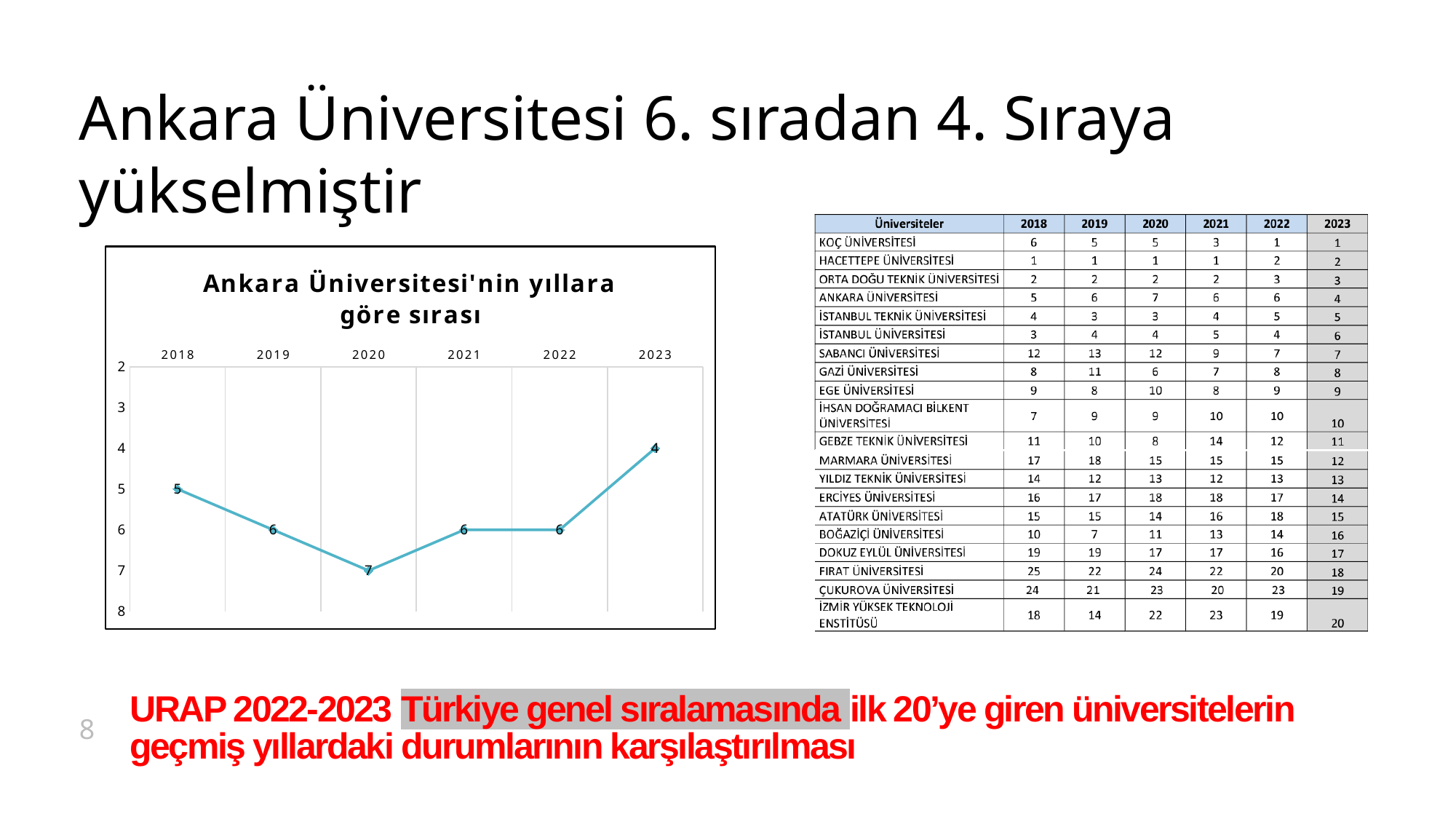
How many years are plotted on the x axis of the chart? 6 What is the plotted value for 2018 in the chart 'Ankara Üniversitesi'nin yıllara göre sırası'? 5 What kind of chart is shown on the slide? line chart What is the difference between the plotted values for 2020 and 2023? 3 Does the plotted value rise or fall from 2022 to 2023? fall Which year has the largest plotted value in the chart? 2020 What is the title of the chart on the slide? Ankara Üniversitesi'nin yıllara göre sırası Which year has the larger plotted value, 2018 or 2019? 2019 What is the plotted value for 2020 in the chart? 7 Which year has the smallest plotted value in the chart? 2023 What is the plotted value for 2023 in the chart? 4 What is the plotted value for 2021 in the chart? 6